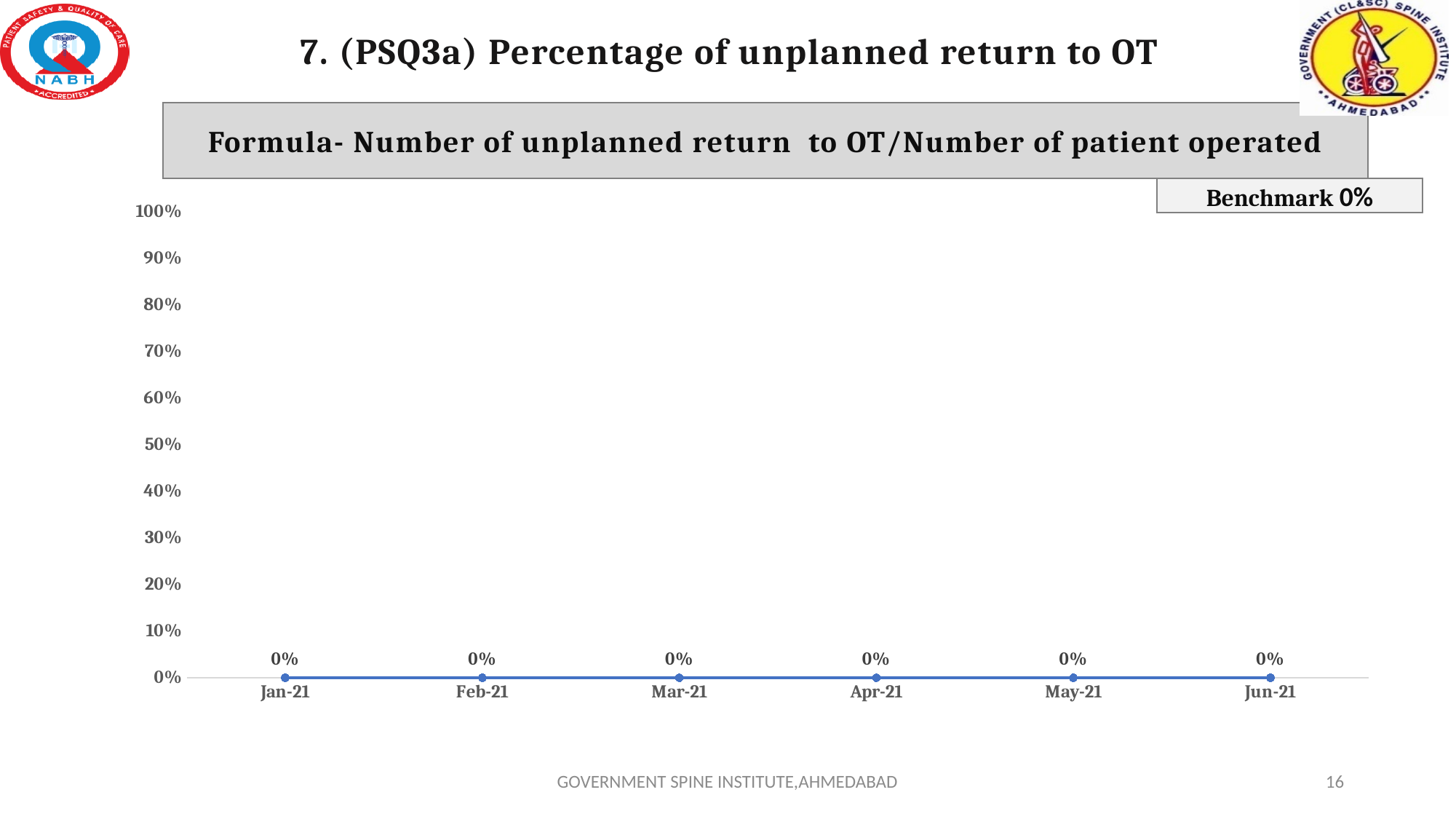
Is the value for Feb-21 greater or less than 50%? less What is the value for Apr-21? 0% What is the benchmark value shown on the slide? 0% Do the values rise, fall, or stay flat from Jan-21 to Jun-21? stay flat What is the highest value shown on the y axis? 100% Is the value for Jun-21 greater or less than 10%? less What kind of chart is shown on the slide? line chart What is the value for Jan-21? 0% What is the difference between the values for Mar-21 and May-21? 0% How many months are plotted on the x axis? 6 What is the value for Jun-21? 0%